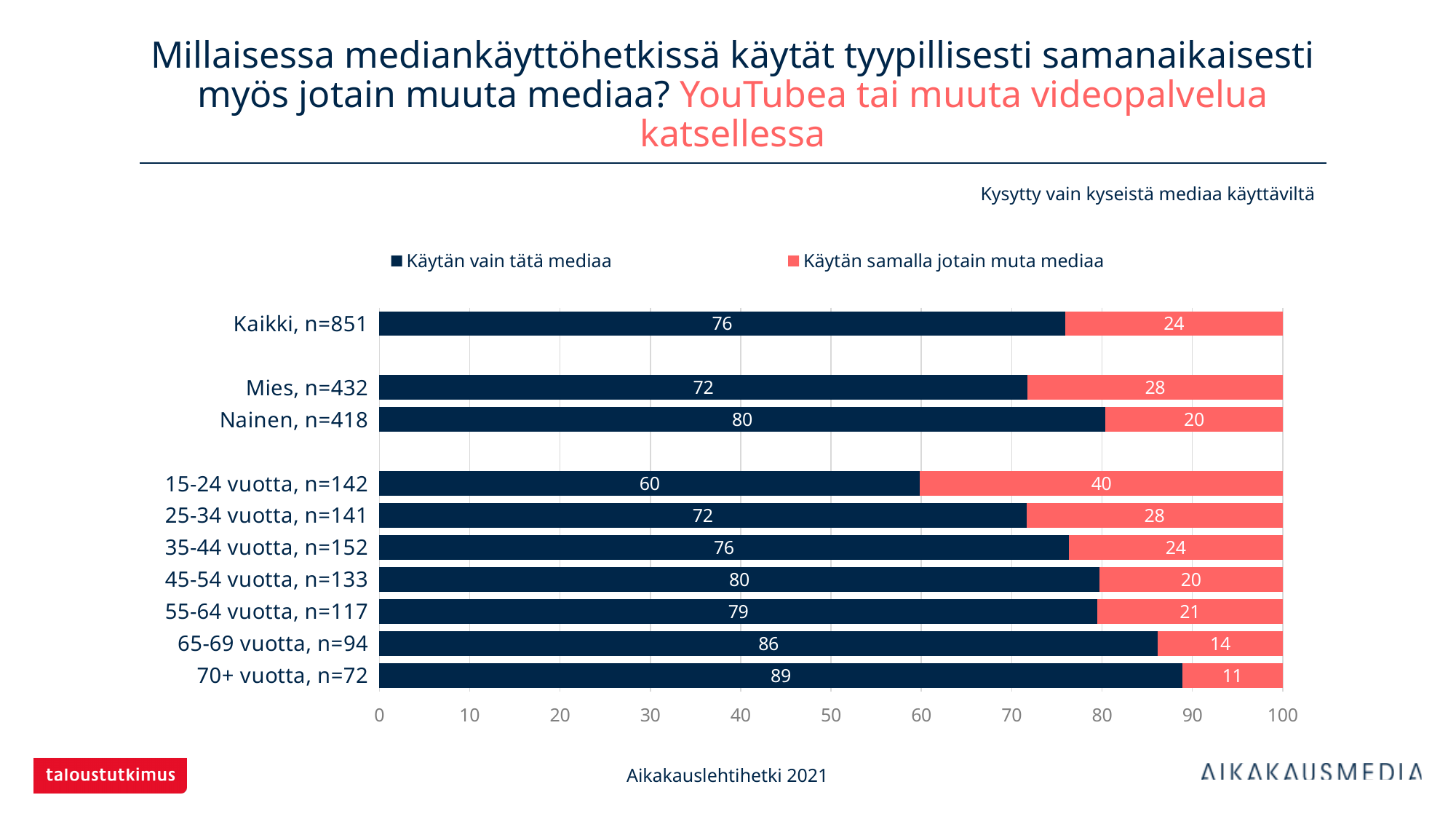
What is the value of "Käytän samalla jotain muta mediaa" for 15-24 vuotta, n=142? 40 Which category has the lowest value for "Käytän vain tätä mediaa"? 15-24 vuotta, n=142 How many categories are shown in the chart? 10 What is the total of the stacked bar for 45-54 vuotta, n=133? 100 What is the difference between the "Käytän vain tätä mediaa" values for Nainen, n=418 and Mies, n=432? 8 Which colour represents "Käytän samalla jotain muta mediaa" in the chart? Red (coral) What kind of chart is shown on the slide? Stacked bar chart What is the value of "Käytän vain tätä mediaa" for Kaikki, n=851? 76 Which has a larger "Käytän samalla jotain muta mediaa" value, 65-69 vuotta, n=94 or 55-64 vuotta, n=117? 55-64 vuotta, n=117 What is the value of "Käytän vain tätä mediaa" for 70+ vuotta, n=72? 89 How many series does the legend list? 2 Which category has the highest value for "Käytän samalla jotain muta mediaa"? 15-24 vuotta, n=142